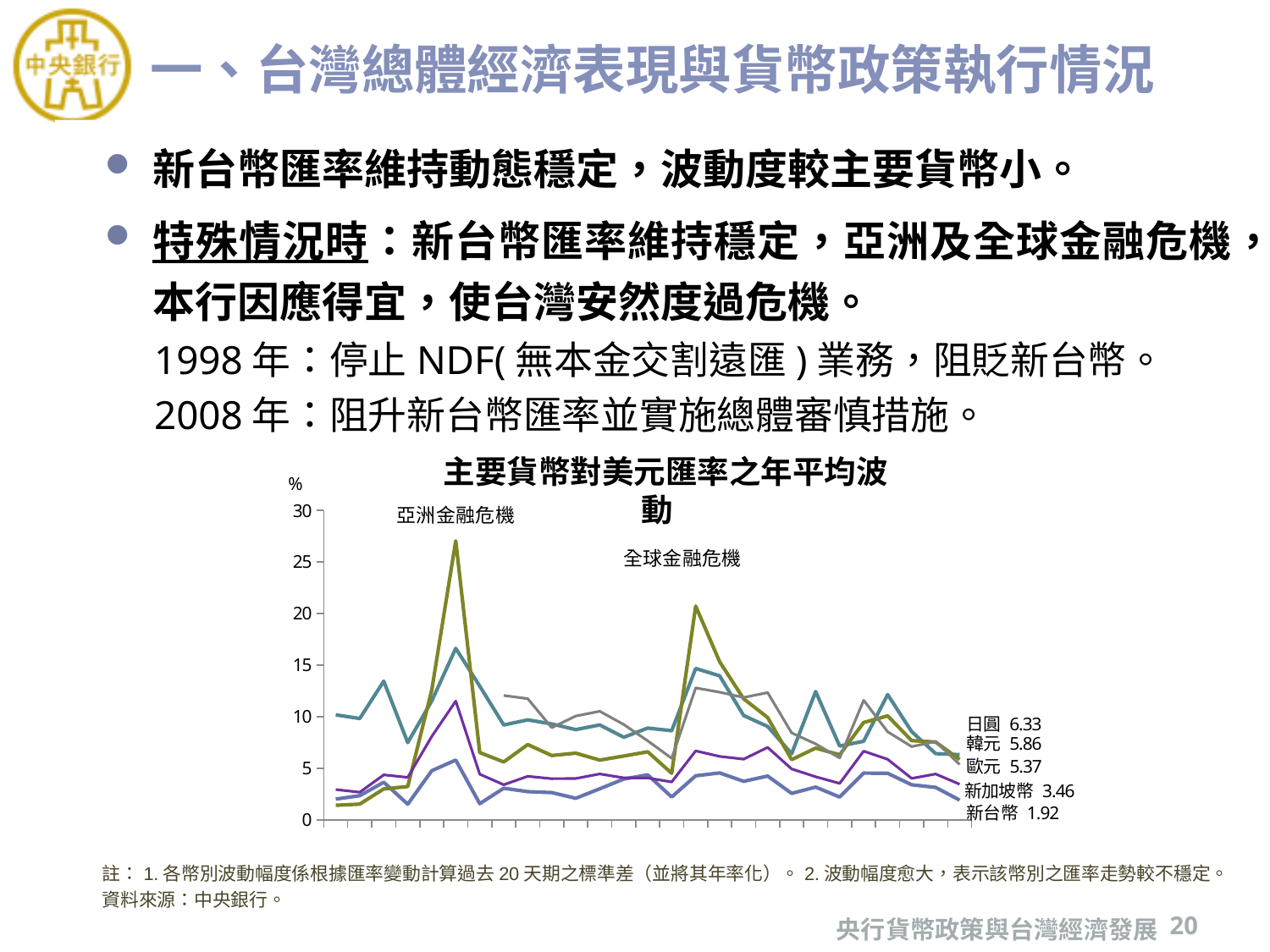
What is the final value shown for 歐元 on the chart? 5.37 What is the final value shown for 新加坡幣 on the chart? 3.46 Which has the larger final value, 歐元 or 新加坡幣? 歐元 Is the highest peak on the chart, during the 亞洲金融危機, greater or less than 25? greater What kind of chart is shown on the slide? line chart What is the final value shown for 韓元 on the chart? 5.86 How many currency series are labelled on the chart? 5 Which currency has the lowest final value labelled on the chart? 新台幣 Which currency has the highest final value labelled on the chart? 日圓 What is the final value shown for 新台幣 on the chart? 1.92 What is the final value shown for 日圓 on the chart? 6.33 What is the difference between the final values of 日圓 and 新台幣? 4.41